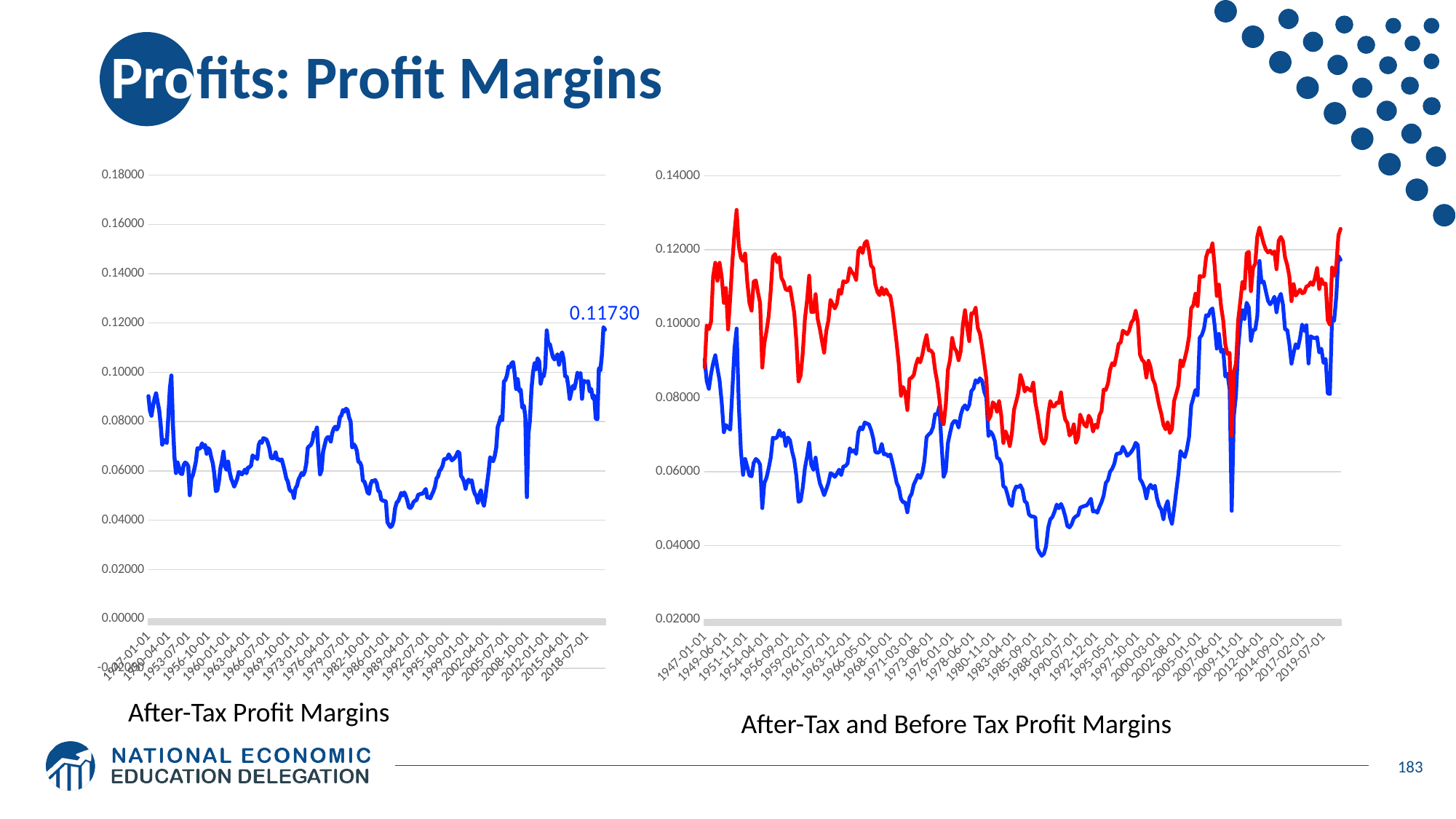
On the left chart "After-Tax Profit Margins", is the value at 1947-01-01 greater or less than 0.08? greater On the left chart "After-Tax Profit Margins", what value is printed as the data label at the end of the line? 0.11730 On the right chart "After-Tax and Before Tax Profit Margins", which line is higher throughout, the red line or the blue line? red On the right chart "After-Tax and Before Tax Profit Margins", is the blue line's value at 2019-07-01 greater or less than 0.10? less On the left chart "After-Tax Profit Margins", does the line rise or fall between 1979-07-01 and 1986-01-01? fall What kind of chart is the left chart titled "After-Tax Profit Margins"? line chart How many lines are plotted on the right chart "After-Tax and Before Tax Profit Margins"? 2 On the left chart "After-Tax Profit Margins", does the line rise or fall overall between 2002-04-01 and 2018-07-01? rise On the right chart "After-Tax and Before Tax Profit Margins", is the peak of the red line around 1951-11-01 greater or less than 0.12? greater What is the highest y-axis tick shown on the right chart "After-Tax and Before Tax Profit Margins"? 0.14000 What is the caption below the left chart? After-Tax Profit Margins